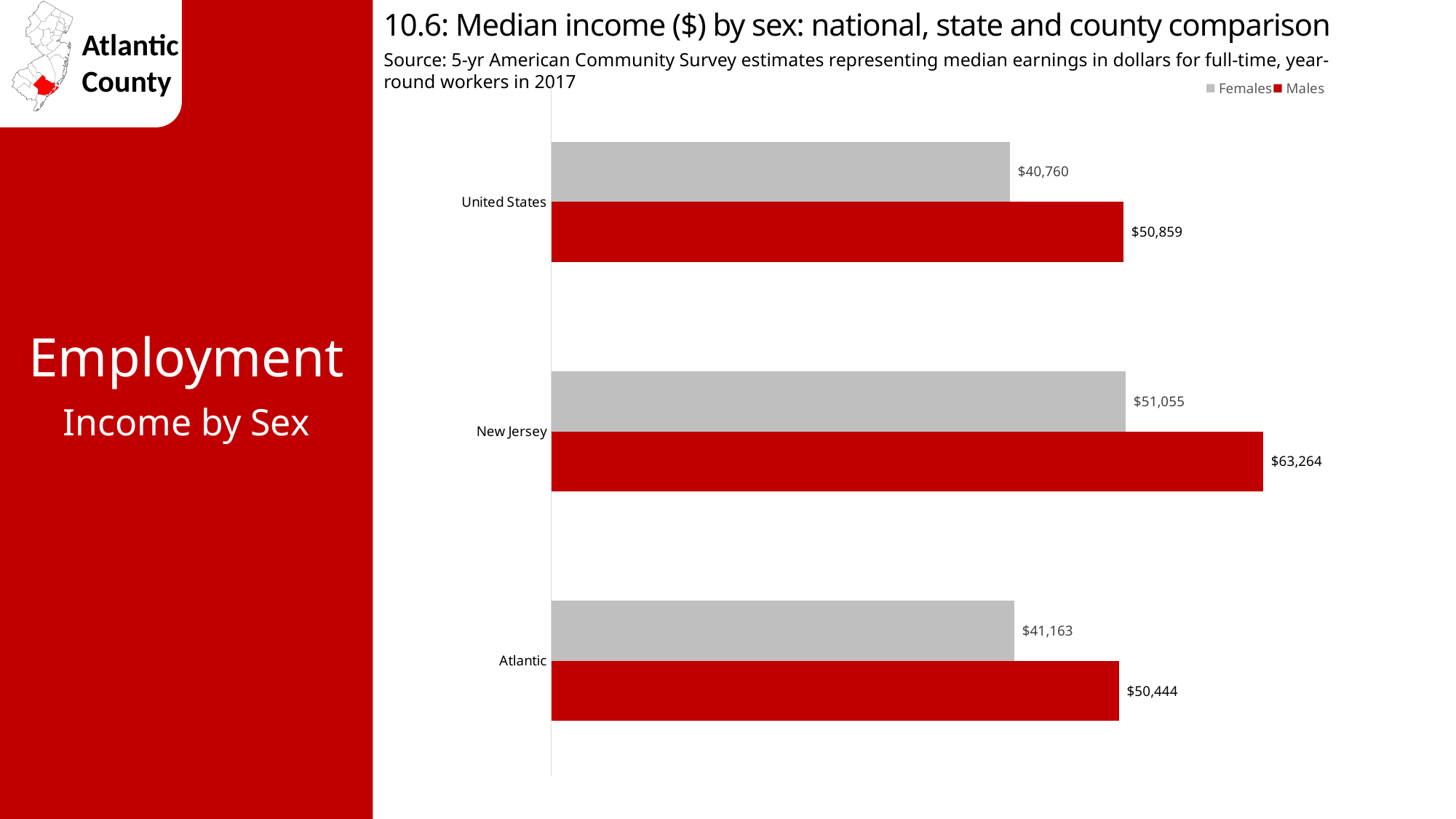
What is the median income for females in the United States? $40,760 How many series does the legend list? 2 What is the median income for males in New Jersey? $63,264 Which geography has the highest median income for males? New Jersey What is the difference between male and female median income in Atlantic? $9,281 What is the median income for females in New Jersey? $51,055 What is the median income for males in Atlantic? $50,444 What is the difference between male and female median income in New Jersey? $12,209 Which geography has the lowest median income for females? United States What kind of chart is shown on the slide? Bar chart How many geographies are shown on the chart? 3 Which is larger: the median income for males in the United States or for males in Atlantic? United States